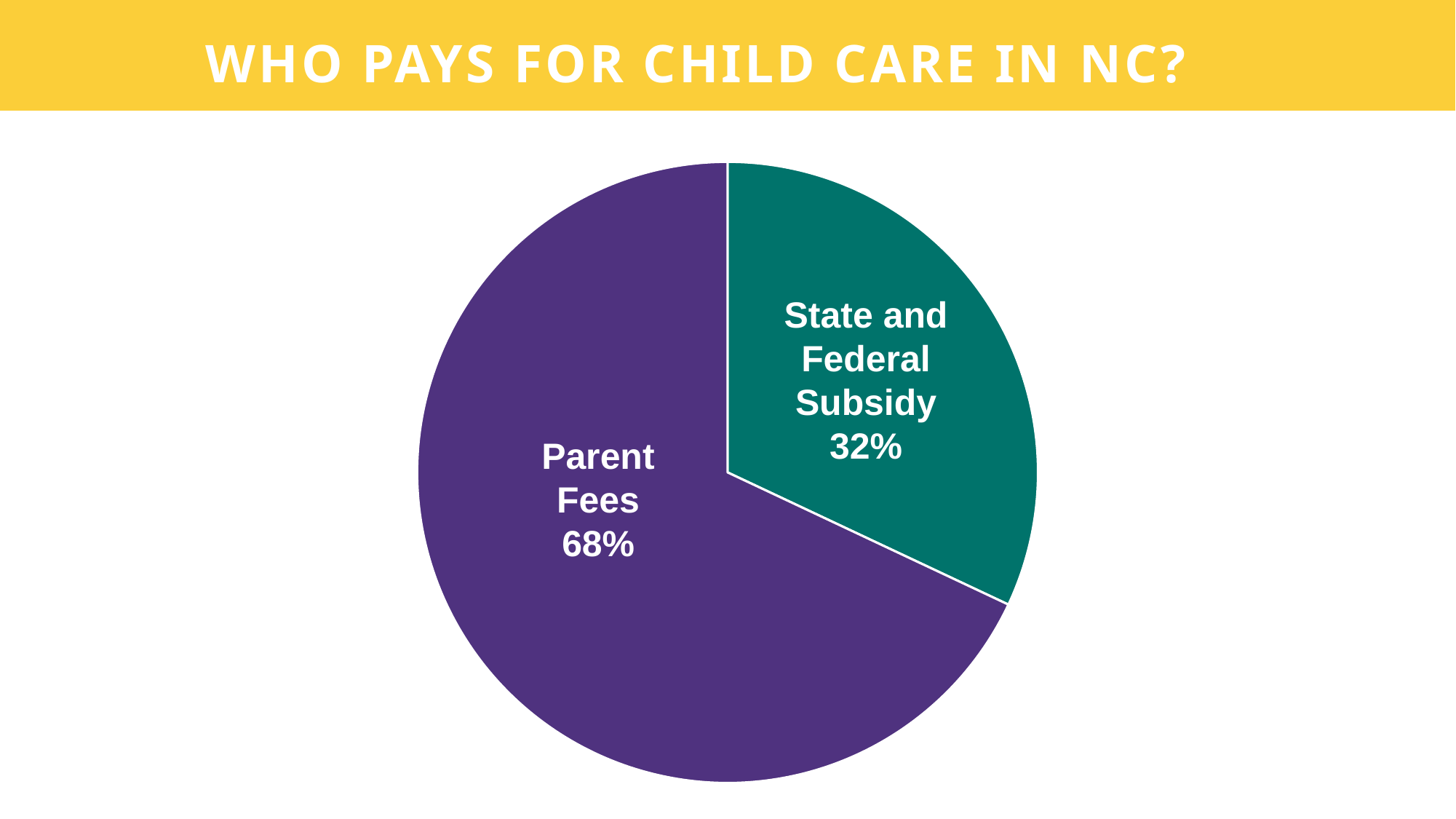
Is the share for State and Federal Subsidy greater or less than 50%? less What share of child care costs in NC is paid by Parent Fees? 68% What is the difference in percentage points between Parent Fees and State and Federal Subsidy? 36 Which slice of the pie is the largest? Parent Fees How many slices does the pie chart have? 2 What is the total of the two slices shown? 100% Which slice of the pie is the smallest? State and Federal Subsidy What share of child care costs in NC is paid by State and Federal Subsidy? 32% What colour is the Parent Fees slice? purple What kind of chart is shown on the slide? pie chart What is the title of the slide? WHO PAYS FOR CHILD CARE IN NC? Which is larger, the Parent Fees slice or the State and Federal Subsidy slice? Parent Fees